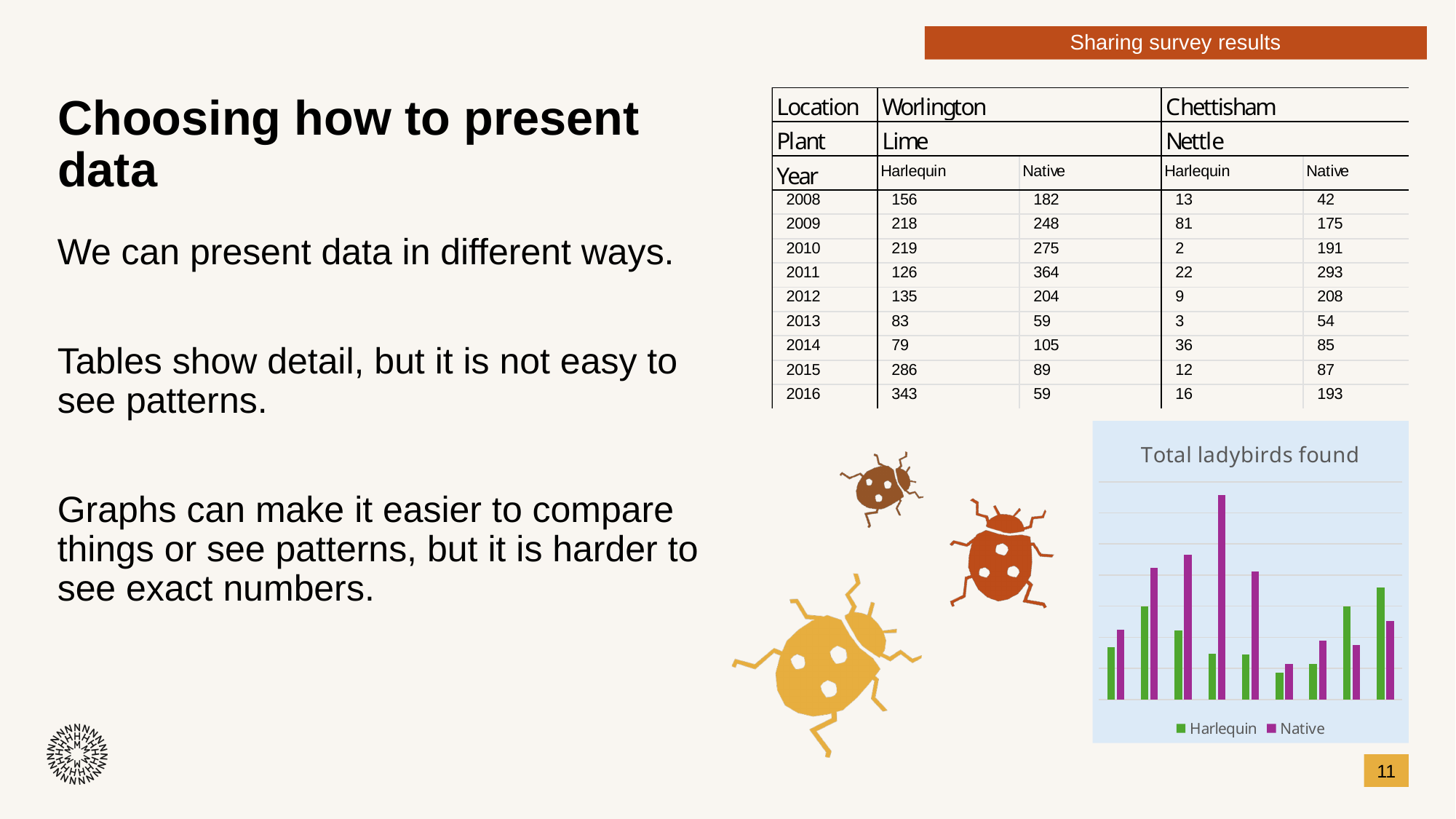
How many groups of bars are plotted in the "Total ladybirds found" chart? 9 In the "Total ladybirds found" chart, which series is taller in the fifth group of bars, Harlequin or Native? Native In the "Total ladybirds found" chart, which series is taller in the first group of bars, Harlequin or Native? Native What kind of chart is the "Total ladybirds found" chart? bar chart What is the title of the chart on the slide? Total ladybirds found What are the two series named in the legend of the "Total ladybirds found" chart? Harlequin and Native In the "Total ladybirds found" chart, which series is taller in the last group of bars, Harlequin or Native? Harlequin In the "Total ladybirds found" chart, which series has the shortest bar overall? Harlequin How many series does the legend of the "Total ladybirds found" chart list? 2 In the "Total ladybirds found" chart, which series has the tallest bar overall? Native